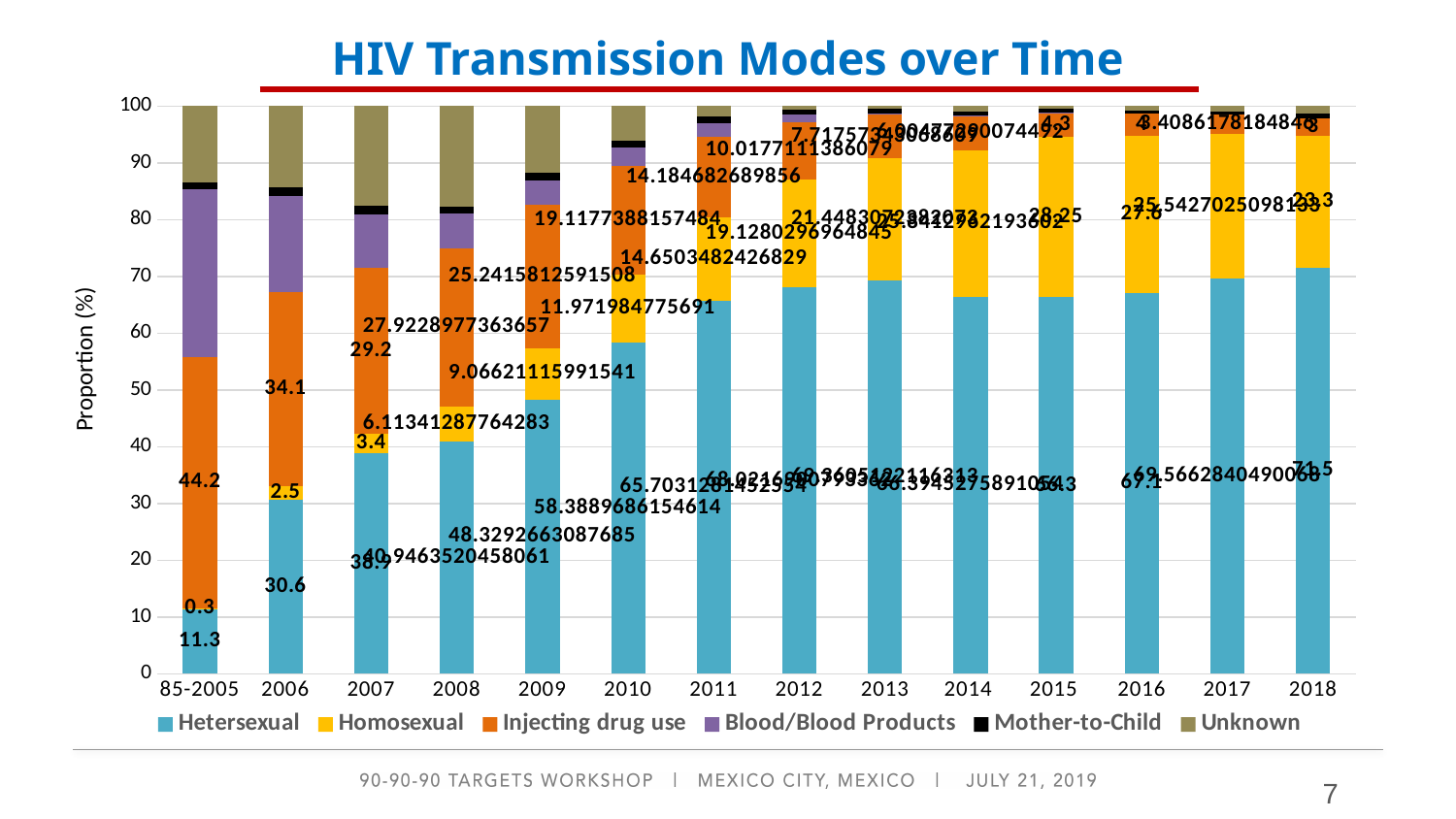
What is the Homosexual proportion for 2016? 27.6 What type of chart is shown on the slide? Stacked bar chart What is the Heterosexual proportion for 2018? 71.5 What is the Heterosexual proportion for 2006? 30.6 Which period has the lowest Heterosexual proportion? 85-2005 In 2006, which is larger: the Heterosexual proportion or the Injecting drug use proportion? Injecting drug use What is the Injecting drug use proportion for 85-2005? 44.2 By how much does the Heterosexual proportion in 2018 exceed that in 2006? 40.9 How many time periods are shown on the x axis? 14 What is the Injecting drug use proportion for 2007? 29.2 How many series does the legend list? 6 Is the Heterosexual proportion for 2012 greater or less than 60? greater